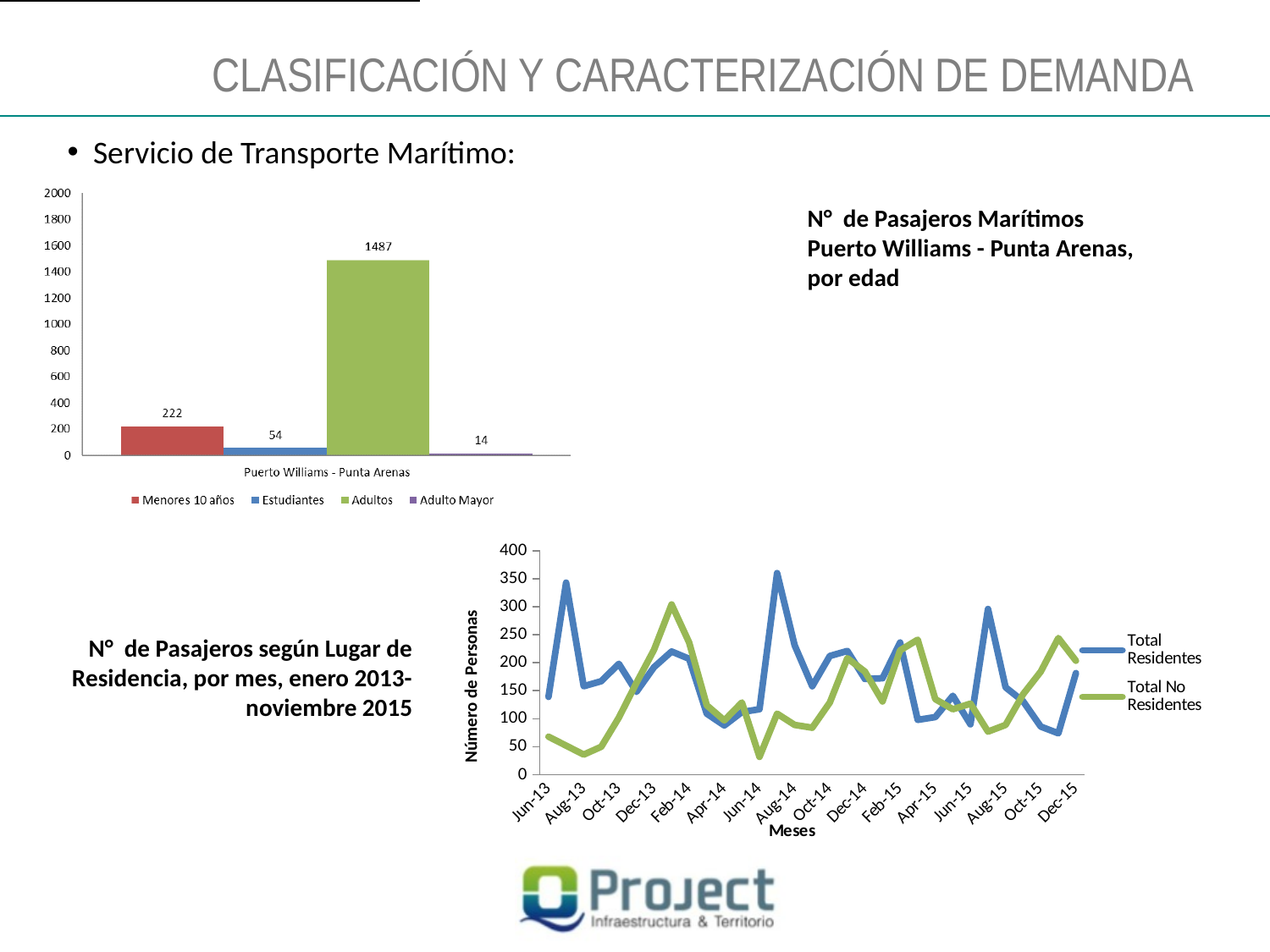
In the bar chart 'N° de Pasajeros Marítimos Puerto Williams - Punta Arenas, por edad', which category has the lowest value? Adulto Mayor How many series does the legend of the line chart 'N° de Pasajeros según Lugar de Residencia, por mes, enero 2013-noviembre 2015' list? 2 In the line chart 'N° de Pasajeros según Lugar de Residencia, por mes, enero 2013-noviembre 2015', is the value for Total Residentes in Aug-13 greater or less than 300? less How many series does the legend of the bar chart 'N° de Pasajeros Marítimos Puerto Williams - Punta Arenas, por edad' list? 4 In the line chart 'N° de Pasajeros según Lugar de Residencia, por mes, enero 2013-noviembre 2015', what is the label of the y axis? Número de Personas In the bar chart 'N° de Pasajeros Marítimos Puerto Williams - Punta Arenas, por edad', what is the value for Menores 10 años? 222 In the bar chart 'N° de Pasajeros Marítimos Puerto Williams - Punta Arenas, por edad', what is the difference between Adultos and Menores 10 años? 1265 What kind of chart is 'N° de Pasajeros según Lugar de Residencia, por mes, enero 2013-noviembre 2015'? Line chart In the bar chart 'N° de Pasajeros Marítimos Puerto Williams - Punta Arenas, por edad', what is the value for Adultos? 1487 In the bar chart 'N° de Pasajeros Marítimos Puerto Williams - Punta Arenas, por edad', what is the value for Estudiantes? 54 In the bar chart 'N° de Pasajeros Marítimos Puerto Williams - Punta Arenas, por edad', which category has the highest value? Adultos In the bar chart 'N° de Pasajeros Marítimos Puerto Williams - Punta Arenas, por edad', which is larger, Estudiantes or Adulto Mayor? Estudiantes